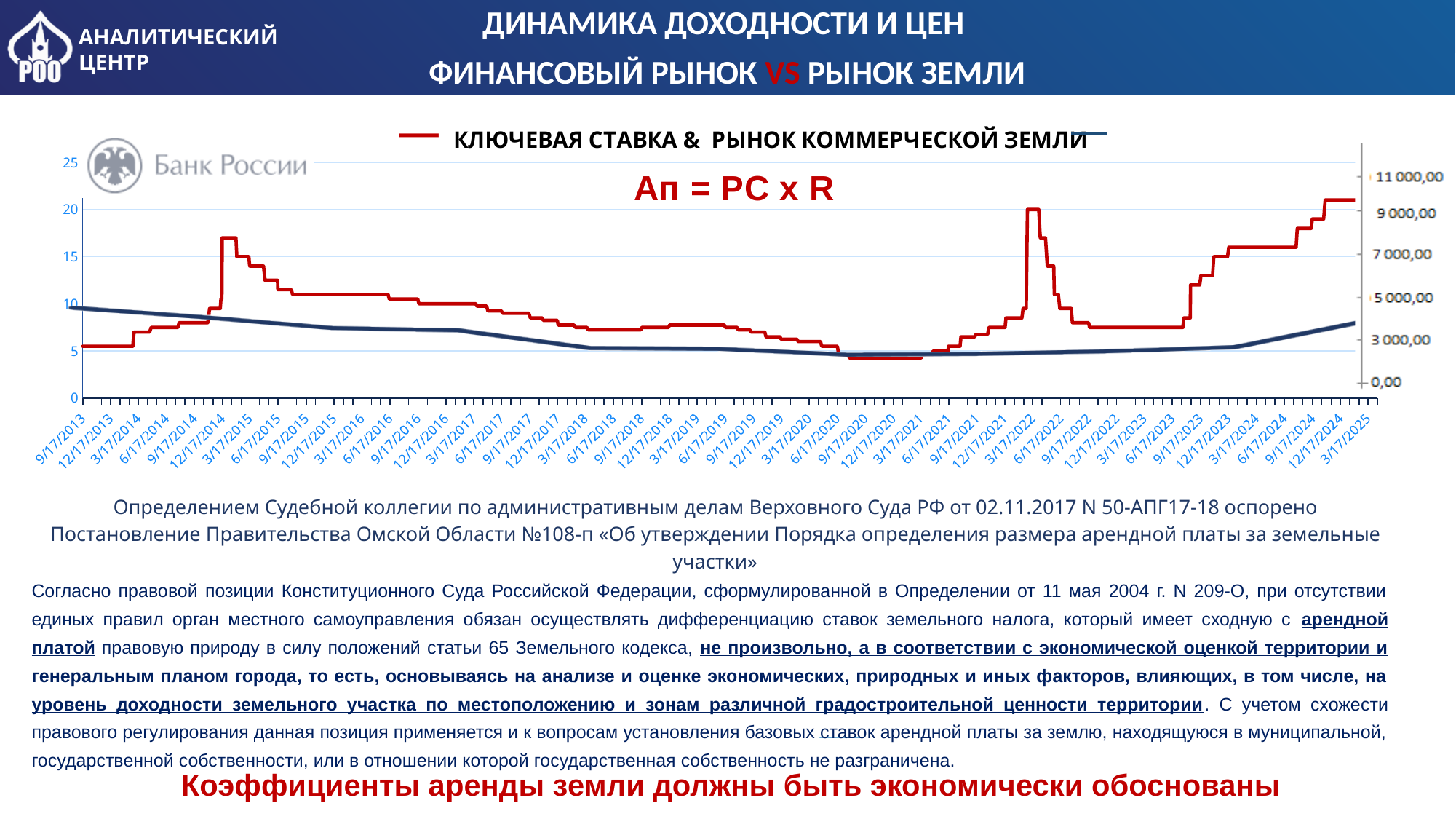
What kind of chart is shown on the slide? line chart On the right axis, is the value of the dark blue line at 12/17/2020 greater or less than 3 000,00? less Does the red line rise or fall between 3/17/2023 and 3/17/2025? rise Which is higher for the red line: its peak near 3/17/2022 or its peak near 3/17/2015? 3/17/2022 Is the value of the red line at 9/17/2020 greater or less than 5? less Does the dark blue line rise or fall between 9/17/2013 and 12/17/2020? fall Is the value of the red line at 3/17/2022 greater or less than 15? greater What is the title of the chart? КЛЮЧЕВАЯ СТАВКА & РЫНОК КОММЕРЧЕСКОЙ ЗЕМЛИ What formula is printed in red inside the chart area? Ап = РС x R How many lines (series) are plotted on the chart? 2 What is the highest tick value shown on the left vertical axis? 25